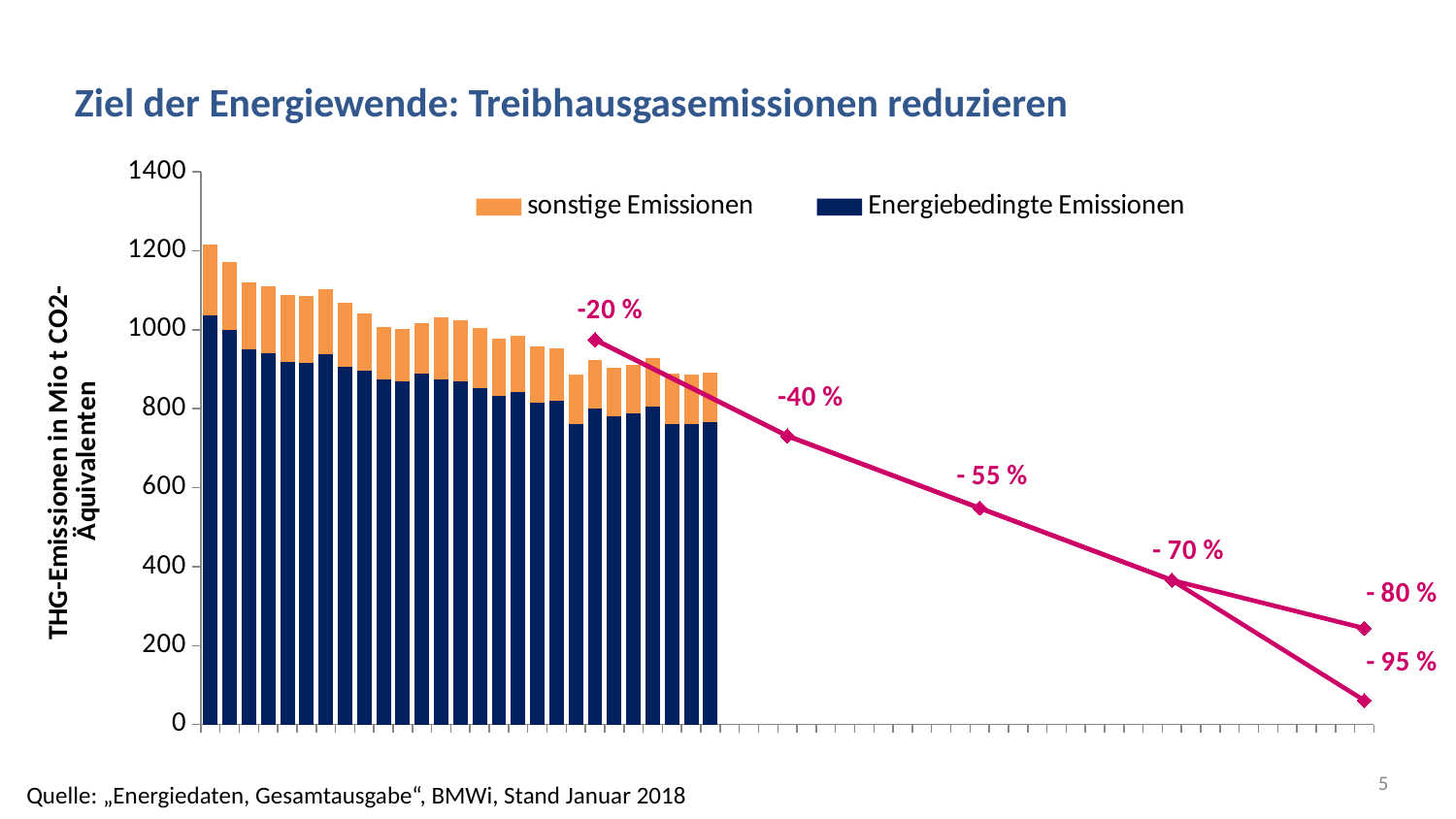
How many series does the legend list? 2 What is the label shown at the first marker of the pink line? -20 % Is the value of the pink line at the point labelled '- 70 %' greater or less than 400? less What kind of chart is shown on the slide? bar chart (stacked) with a line Is the total of the last (rightmost) stacked bar greater or less than 1000? less Do the stacked bars generally rise or fall from left to right along the x axis? fall Is the total of the first (leftmost) stacked bar greater or less than 1000? greater What is the label of the vertical axis? THG-Emissionen in Mio t CO2-Äquivalenten How many labelled points are there on the pink line? 6 What is the title of the slide's chart? Ziel der Energiewende: Treibhausgasemissionen reduzieren What is the label shown at the lowest end point of the pink line? - 95 % Which is larger, the total of the leftmost stacked bar or the total of the rightmost stacked bar? the leftmost bar